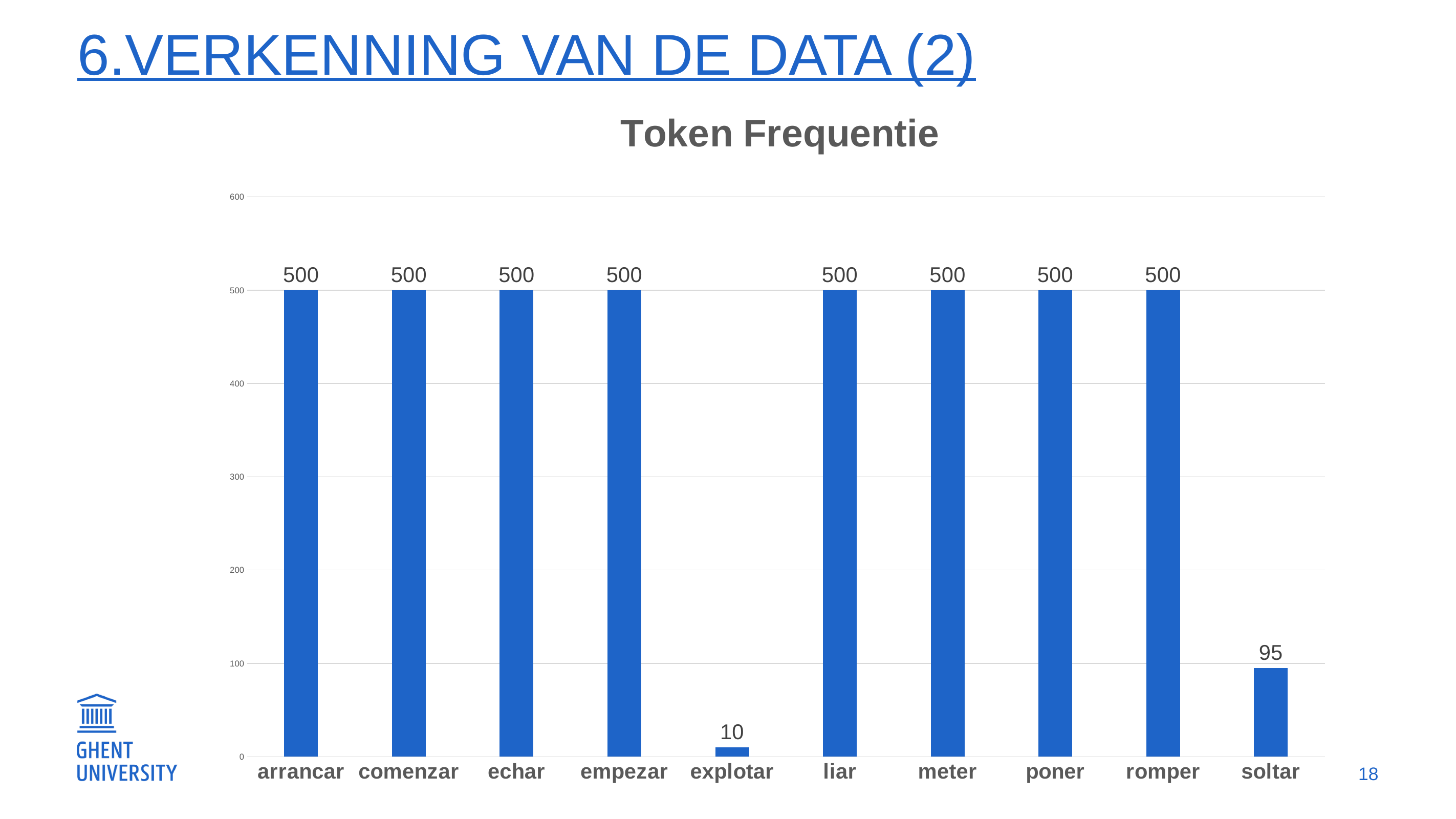
What is the token frequency for arrancar? 500 What is the token frequency for explotar? 10 What kind of chart is shown on the slide? bar chart Which verb has the lowest token frequency? explotar What is the difference between the token frequency of soltar and explotar? 85 What is the title of the chart? Token Frequentie What is the token frequency for soltar? 95 What is the difference between the token frequency of poner and soltar? 405 Is the value for soltar greater or less than 100? less How many verbs are shown on the x axis? 10 Which has a higher token frequency, meter or soltar? meter Which has a higher token frequency, soltar or explotar? soltar